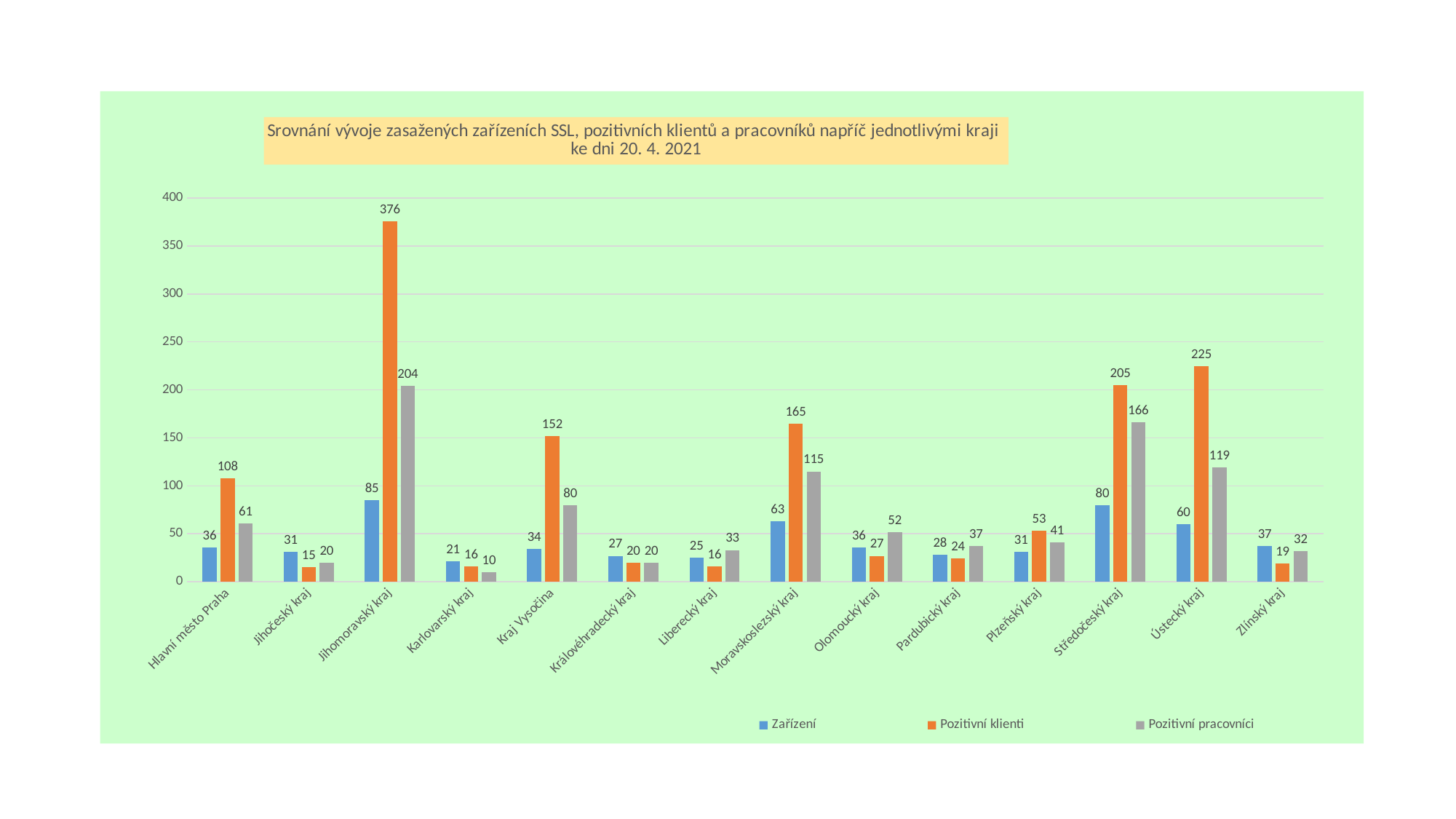
Which colour represents the Pozitivní klienti series? Orange Which region has the lowest value for Pozitivní pracovníci? Karlovarský kraj What is the value of Pozitivní klienti for Jihomoravský kraj? 376 What is the value of Zařízení for Středočeský kraj? 80 How many series does the legend list? 3 How many regions are shown on the x axis? 14 What is the total of the three values for Hlavní město Praha? 205 What is the value of Pozitivní pracovníci for Ústecký kraj? 119 What is the difference between Pozitivní klienti and Pozitivní pracovníci for Středočeský kraj? 39 Which region has the highest value for Pozitivní klienti? Jihomoravský kraj Which is larger for Olomoucký kraj: Zařízení or Pozitivní pracovníci? Pozitivní pracovníci What kind of chart is shown on the slide? Bar chart